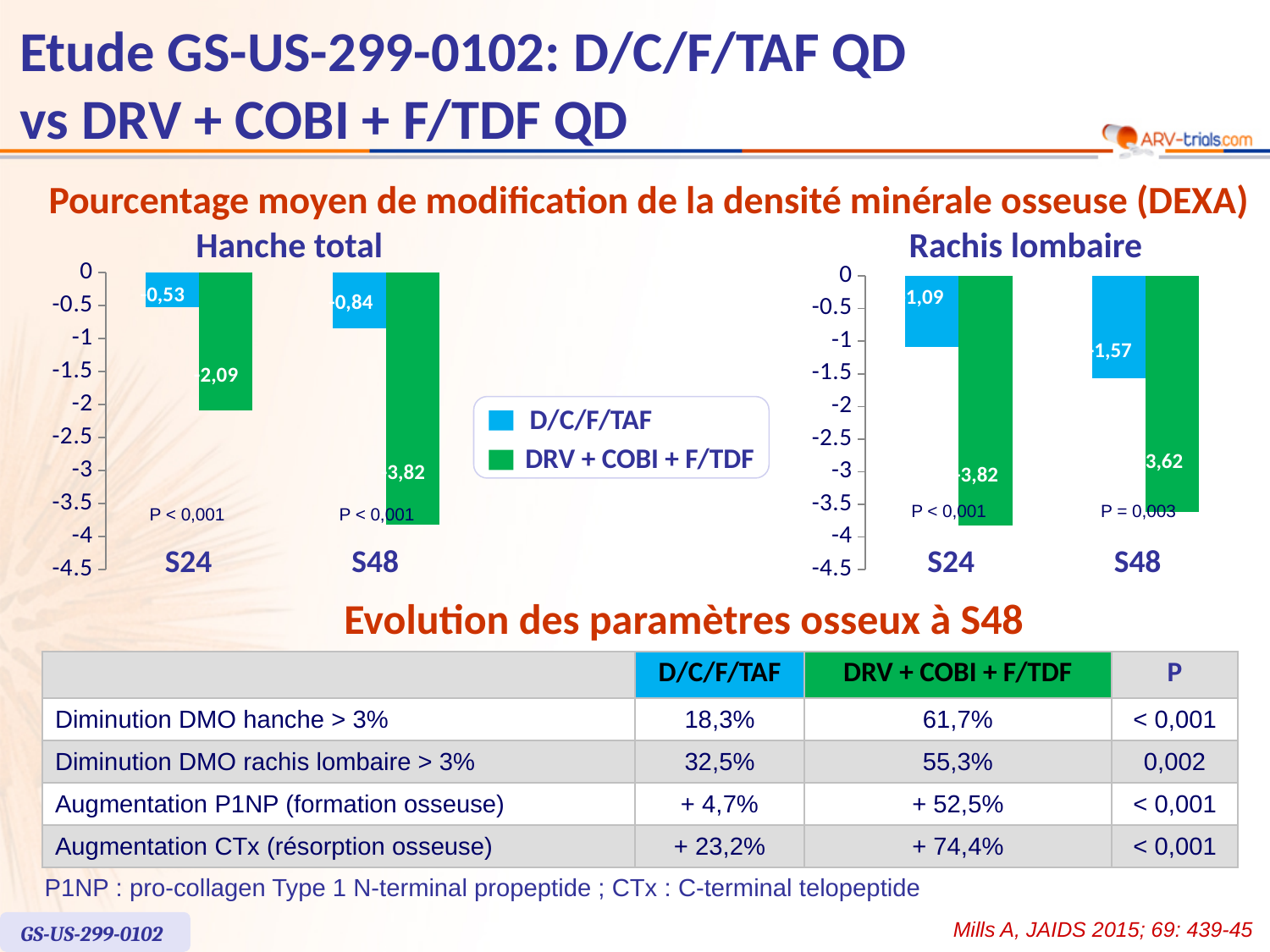
In the 'Rachis lombaire' chart, what is the value for DRV + COBI + F/TDF at S48? -3,62 What kind of chart is used for 'Hanche total'? bar chart In the 'Rachis lombaire' chart, what is the value for DRV + COBI + F/TDF at S24? -3,82 In the 'Hanche total' chart, what is the value for D/C/F/TAF at S48? -0,84 In the 'Hanche total' chart, what is the value for DRV + COBI + F/TDF at S48? -3,82 How many series does the legend list for the charts? 2 In the 'Rachis lombaire' chart, does the D/C/F/TAF value fall or rise from S24 to S48? fall In the 'Rachis lombaire' chart at S48, what is the difference between the DRV + COBI + F/TDF value (-3,62) and the D/C/F/TAF value (-1,57)? 2,05 How many time points (categories) are shown on the x axis of the 'Hanche total' chart? 2 In the 'Hanche total' chart at S48, which group shows the larger decrease in bone mineral density? DRV + COBI + F/TDF What P value is printed under S48 in the 'Rachis lombaire' chart? P = 0,003 In the 'Rachis lombaire' chart, what is the value for D/C/F/TAF at S48? -1,57